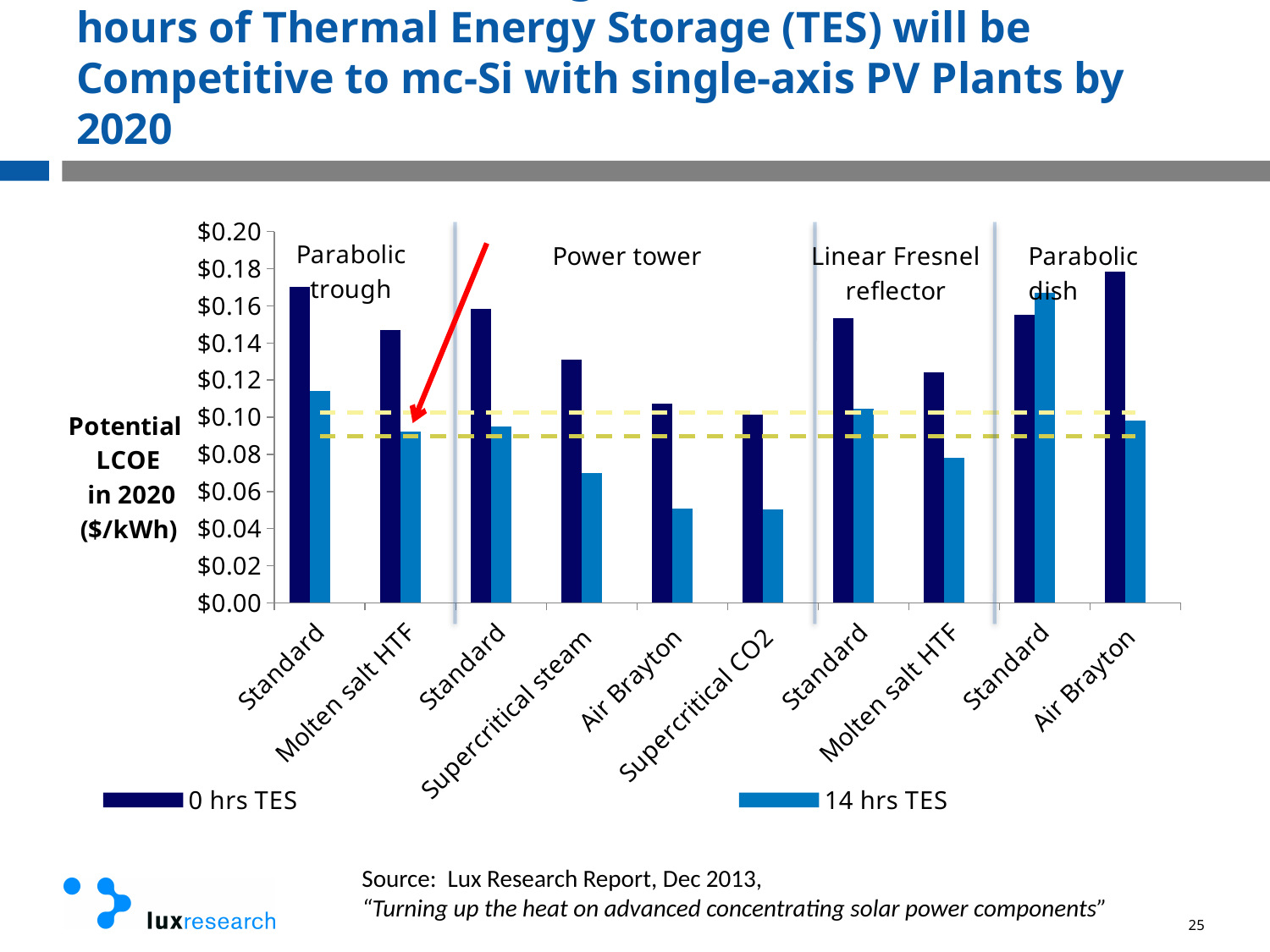
For Standard under Parabolic dish, which is larger: the 0 hrs TES value or the 14 hrs TES value? 14 hrs TES What is the label on the vertical axis of the chart? Potential LCOE in 2020 ($/kWh) Is the 14 hrs TES value for Air Brayton under Power tower greater or less than $0.06? less Is the 0 hrs TES value for Standard under Parabolic trough greater or less than $0.16? greater How many series does the legend list? 2 Is the 14 hrs TES value for Standard under Parabolic dish greater or less than $0.14? greater What kind of chart is shown on the slide? bar chart How many categories are shown along the x axis? 10 Under Power tower, which has the larger 0 hrs TES value: Standard or Supercritical steam? Standard What are the two series named in the legend? 0 hrs TES and 14 hrs TES